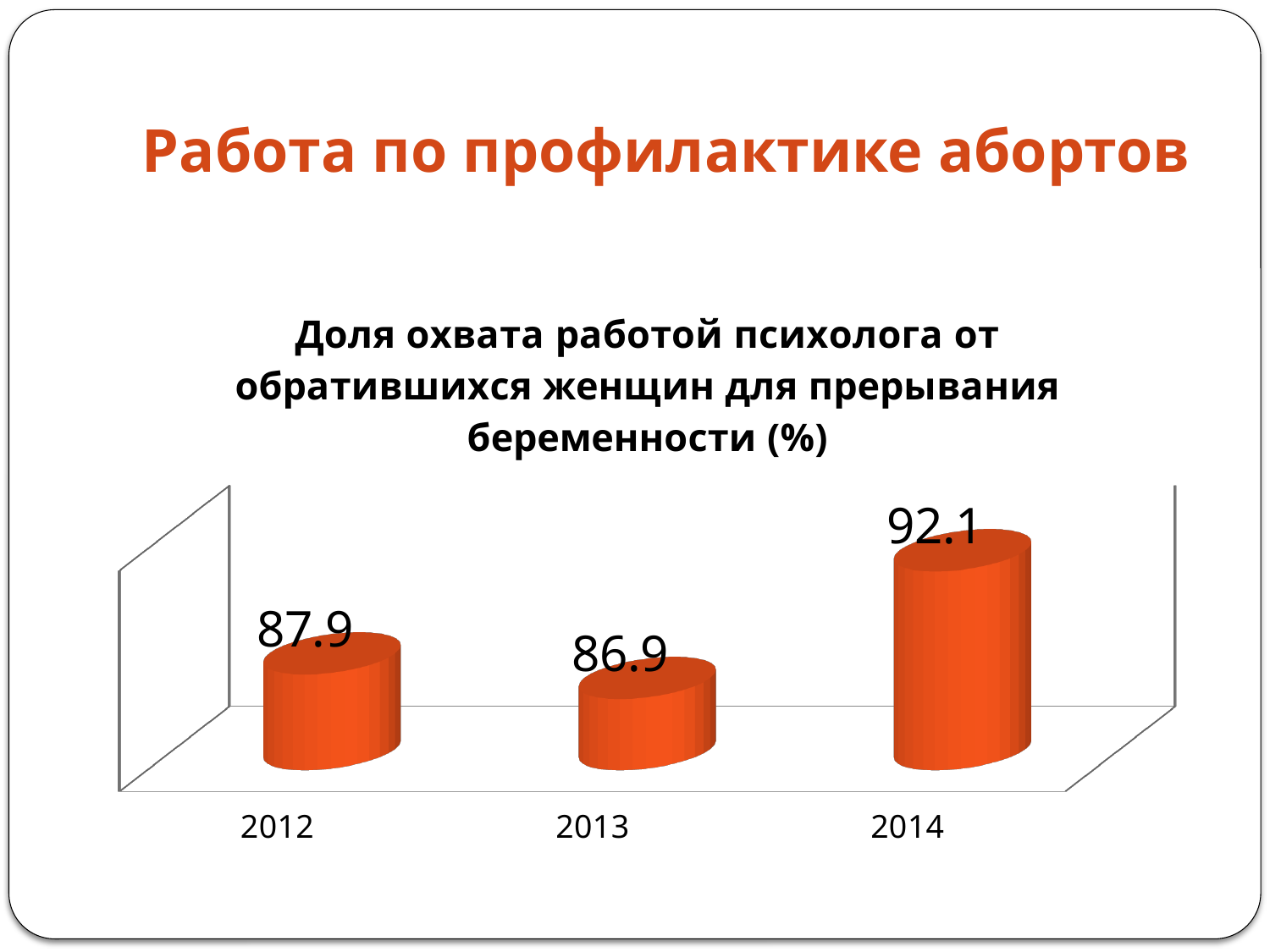
What is the value for 2013? 86.9 Which year has the highest value? 2014 What kind of chart is shown on the slide? bar chart How many years are shown on the chart? 3 What is the difference between the values for 2014 and 2013? 5.2 Which is larger, the value for 2012 or the value for 2014? 2014 What is the title of the chart? Доля охвата работой психолога от обратившихся женщин для прерывания беременности (%) What is the difference between the values for 2012 and 2013? 1.0 What is the value for 2014? 92.1 What is the value for 2012? 87.9 Does the value rise or fall from 2013 to 2014? rise Which year has the lowest value? 2013